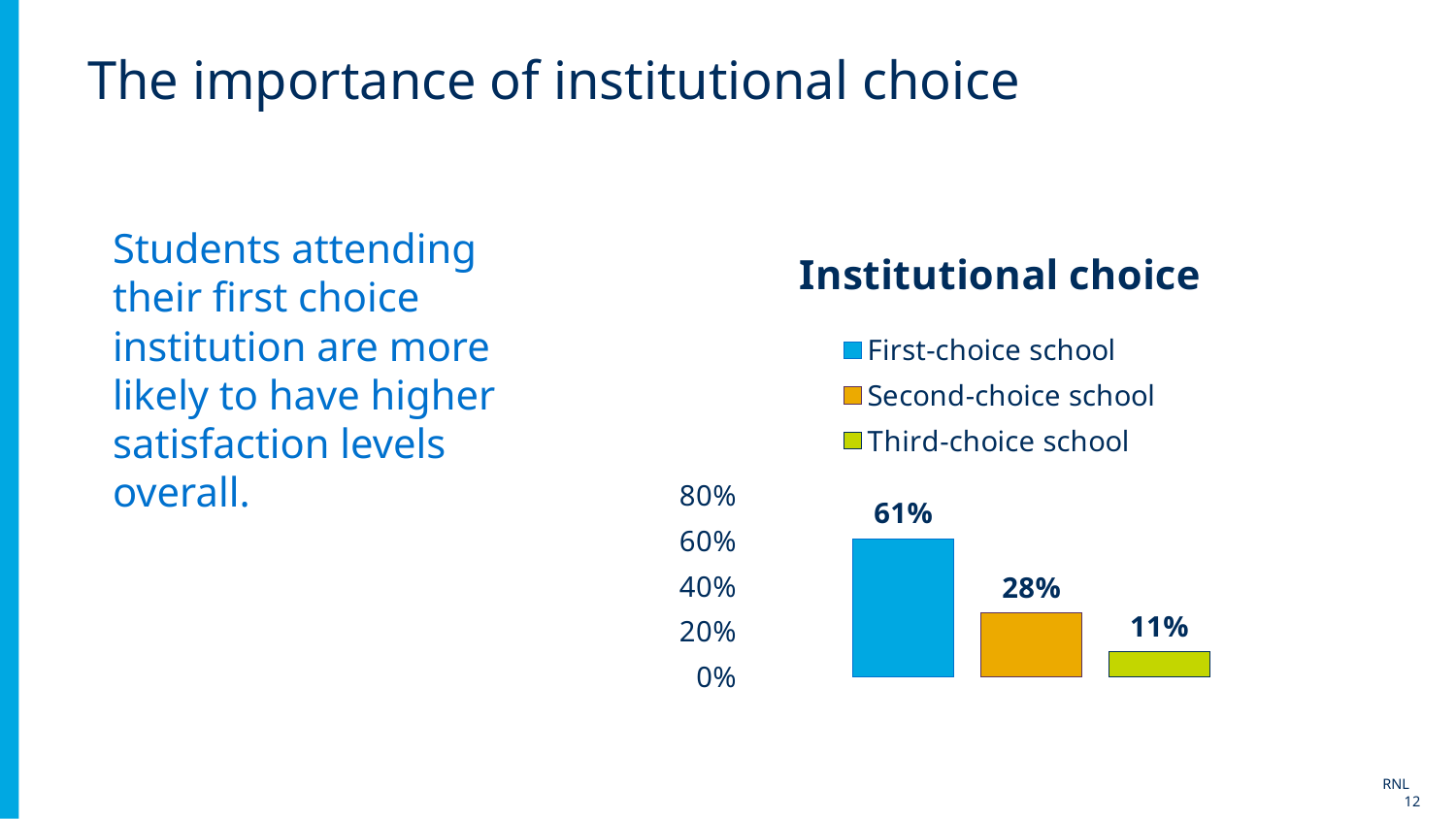
Which is larger, the value for Second-choice school or Third-choice school? Second-choice school What is the value for Third-choice school? 11% What kind of chart is shown? bar chart Is the value for First-choice school greater or less than 40%? greater What is the difference between the Second-choice school and Third-choice school values? 17% What is the title of the chart? Institutional choice What is the difference between the First-choice school and Second-choice school values? 33% Which series has the highest value? First-choice school Which series has the lowest value? Third-choice school How many series does the legend list? 3 What is the value for First-choice school? 61% What is the value for Second-choice school? 28%